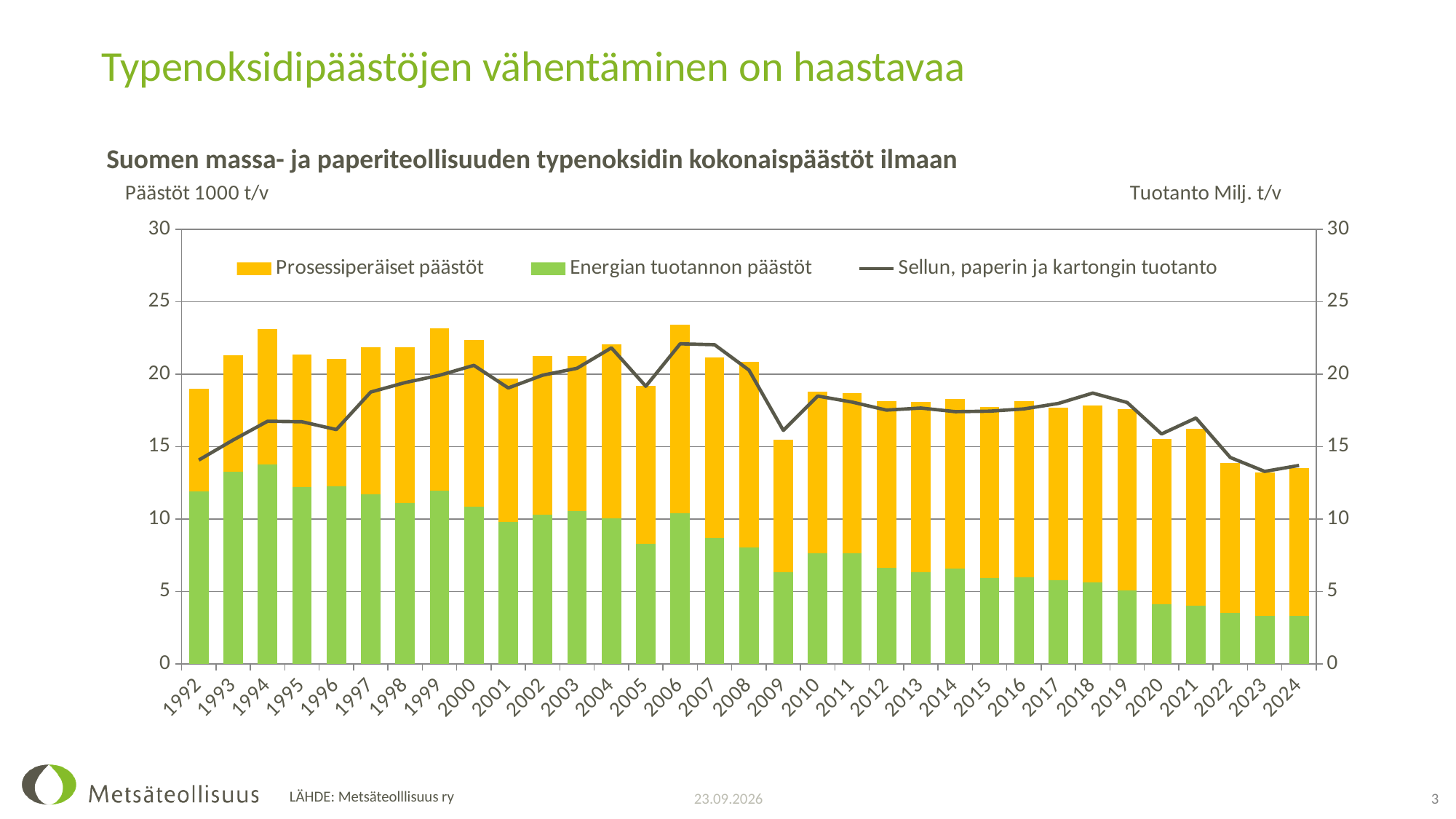
Is the Energian tuotannon päästöt value for 2020 greater or less than 5? less What kind of chart is used to show the emissions (Prosessiperäiset päästöt and Energian tuotannon päästöt)? bar chart How many years are shown on the x axis of the chart? 33 Is the Energian tuotannon päästöt value for 1994 greater or less than 10? greater Which year has the larger total emissions bar, 1994 or 2009? 1994 Do total emissions generally rise or fall from 1992 to 2024? fall Is the total emissions bar for 2022 greater or less than 15? less What colour represents Prosessiperäiset päästöt in the chart? yellow How many series does the chart legend list? 3